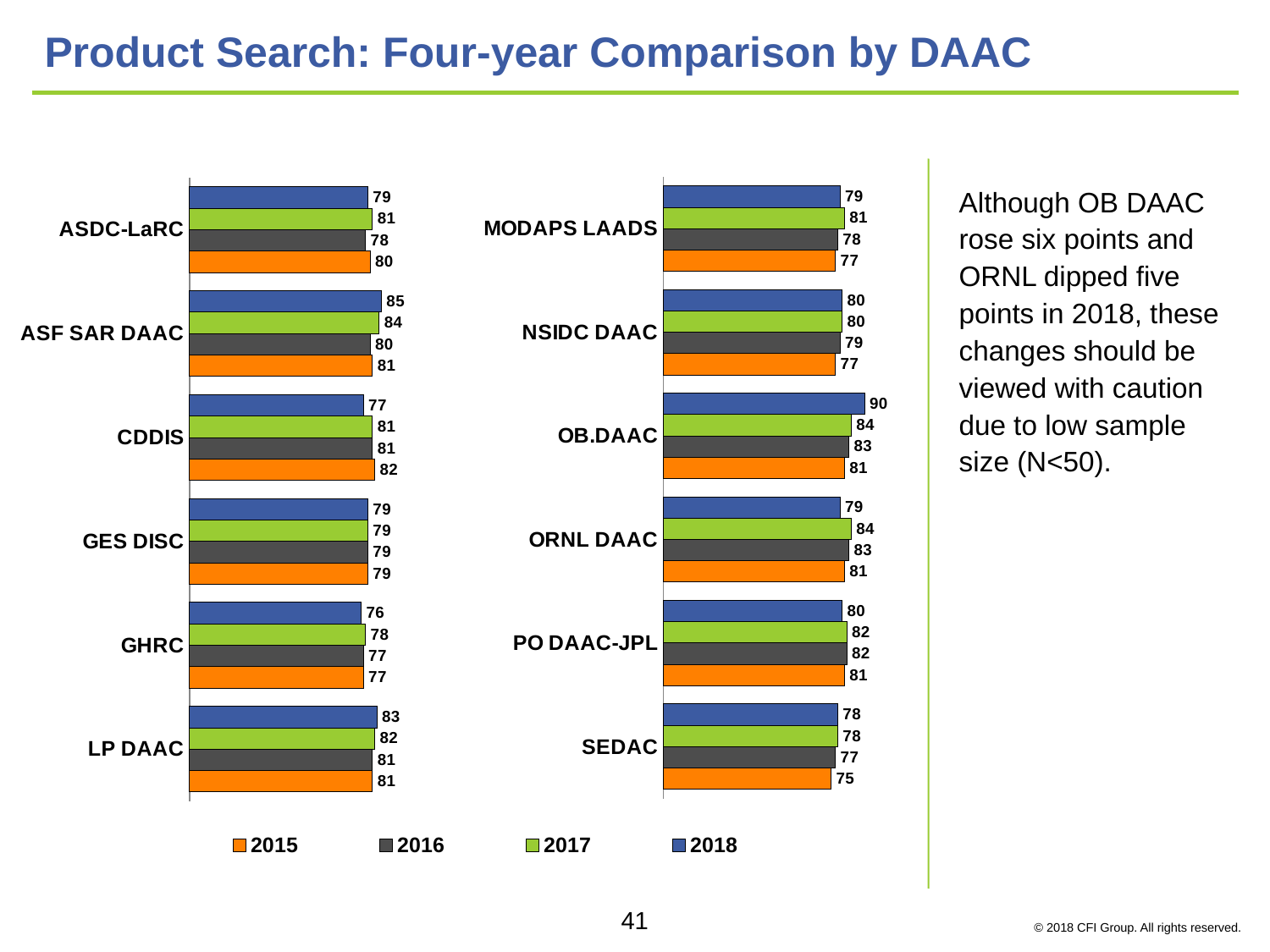
How many series does the legend list? 4 What type of chart is used on this slide? Bar chart In the right chart, what is the difference between the 2018 and 2015 values for OB.DAAC? 9 In the left chart, which DAAC has the lowest 2018 value? GHRC In the left chart, what is the 2018 value for ASF SAR DAAC? 85 In the left chart, what is the difference between the 2018 and 2015 values for CDDIS? 5 How many DAACs are shown in the left chart? 6 In the right chart, did the value for SEDAC rise or fall from 2015 to 2018? Rise In the right chart, which DAAC has the highest 2018 value? OB.DAAC In the right chart, what is the 2017 value for ORNL DAAC? 84 In the left chart, which is larger: the 2018 value for LP DAAC or the 2018 value for CDDIS? LP DAAC In the right chart, what is the 2015 value for SEDAC? 75